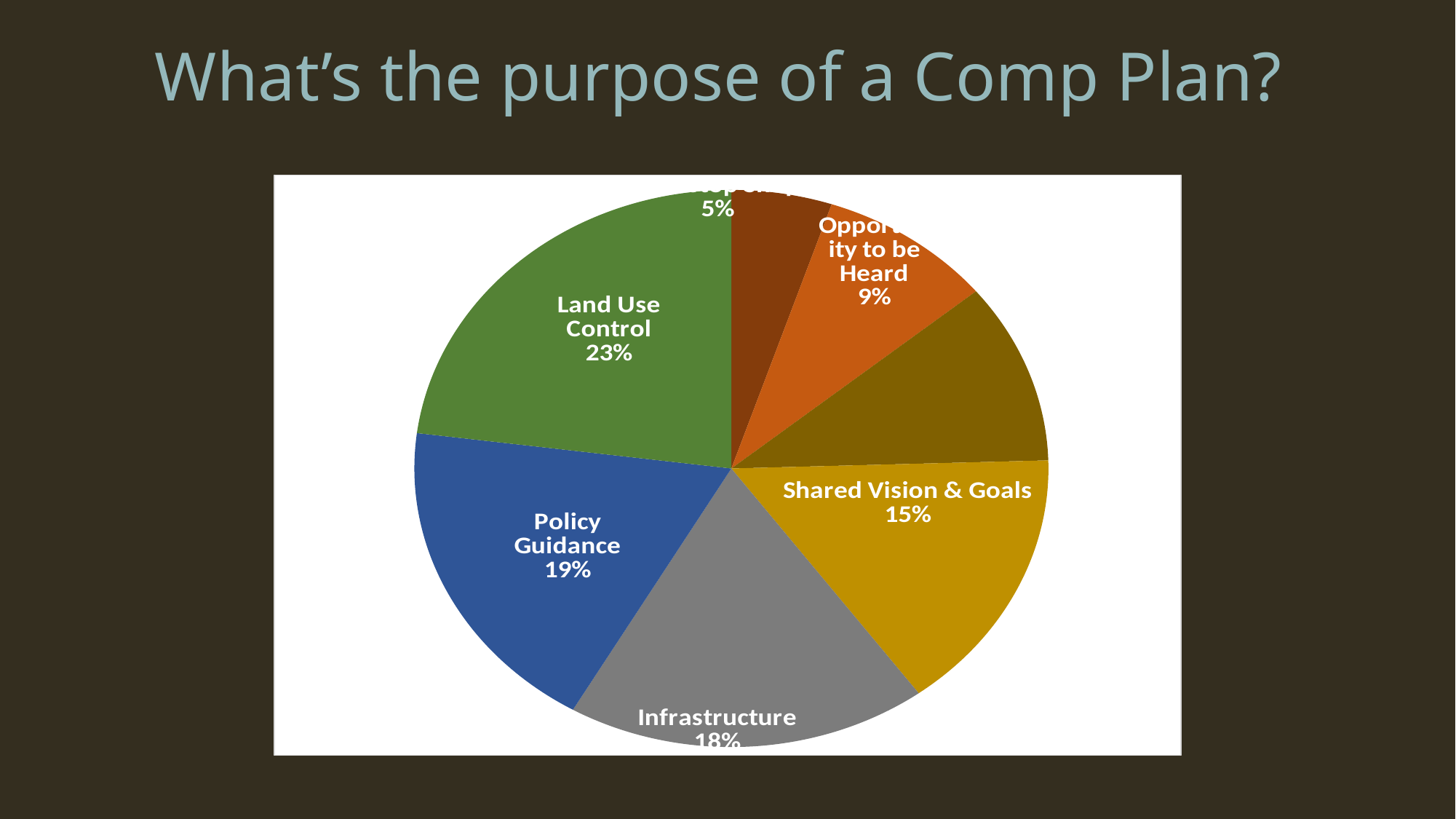
What percentage does the Policy Guidance slice show? 19% Which labeled slice has the largest share of the pie? Land Use Control How many slices does the pie chart have? 7 What colour is the Land Use Control slice? Green How many percentage points larger is Land Use Control than Policy Guidance? 4 What kind of chart is shown on the slide? Pie chart What is the value shown for Infrastructure? 18% What percentage is shown for Opportunity to be Heard? 9% What is the difference in percentage points between Infrastructure and Shared Vision & Goals? 3 Which is larger, the Policy Guidance slice or the Infrastructure slice? Policy Guidance What share of the pie is Shared Vision & Goals? 15% What percentage of the pie is Land Use Control? 23%